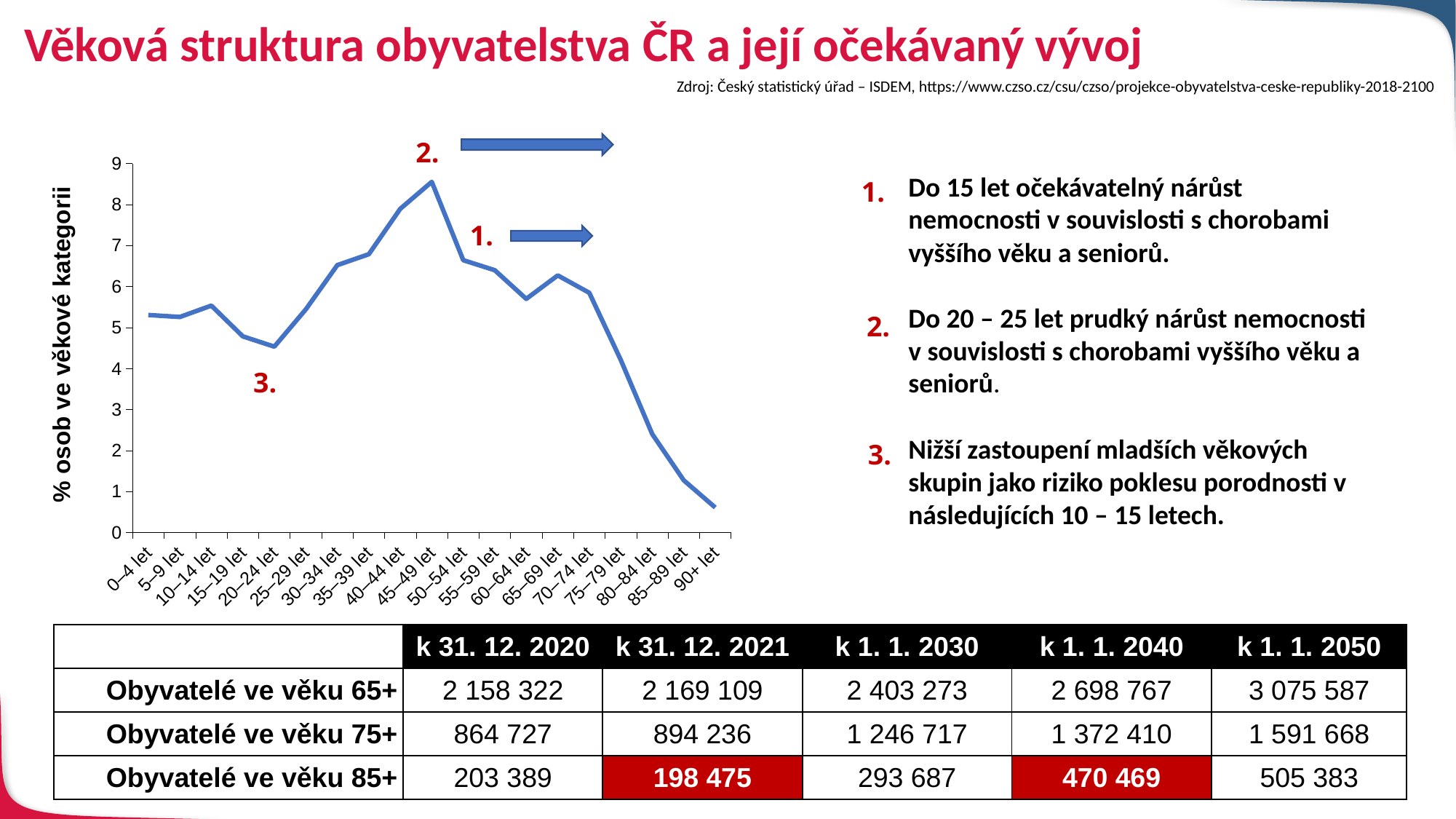
Is the value for 90+ let greater or less than 1? less Which has the larger value, 0–4 let or 90+ let? 0–4 let Is the value for 80–84 let greater or less than 3? less Do the values rise or fall along the x axis from 45–49 let to 90+ let? fall What kind of chart is shown on the slide? line chart How many age categories are plotted along the x axis of the chart? 19 Which age category has the lowest value in the chart? 90+ let Is the value for 20–24 let greater or less than 5? less What is the title of the vertical axis of the chart? % osob ve věkové kategorii Which age category has the highest value in the chart? 45–49 let Which has the larger value, 40–44 let or 60–64 let? 40–44 let